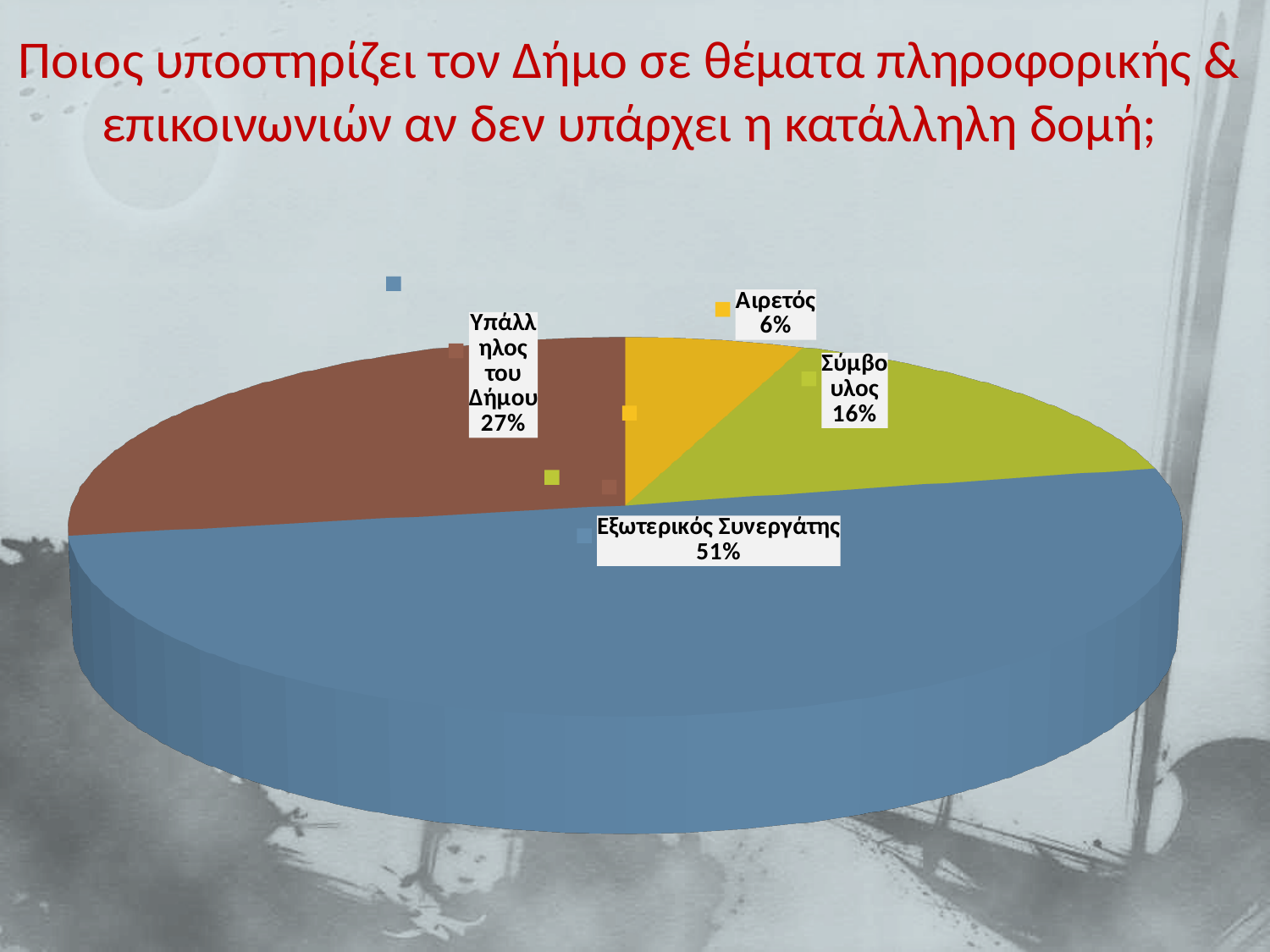
What colour is the slice for Εξωτερικός Συνεργάτης? Blue What is the difference in percentage points between Εξωτερικός Συνεργάτης and Υπάλληλος του Δήμου? 24 What share of the pie does Εξωτερικός Συνεργάτης hold? 51% Which category has the largest slice of the pie? Εξωτερικός Συνεργάτης What is the difference in percentage points between Σύμβουλος and Αιρετός? 10 What is the value shown for Υπάλληλος του Δήμου? 27% Which is larger, the slice for Σύμβουλος or the slice for Υπάλληλος του Δήμου? Υπάλληλος του Δήμου How many slices does the pie chart have? 4 What is the value shown for Σύμβουλος? 16% What is the value shown for Αιρετός? 6% What kind of chart is shown on the slide? Pie chart Which category has the smallest slice of the pie? Αιρετός